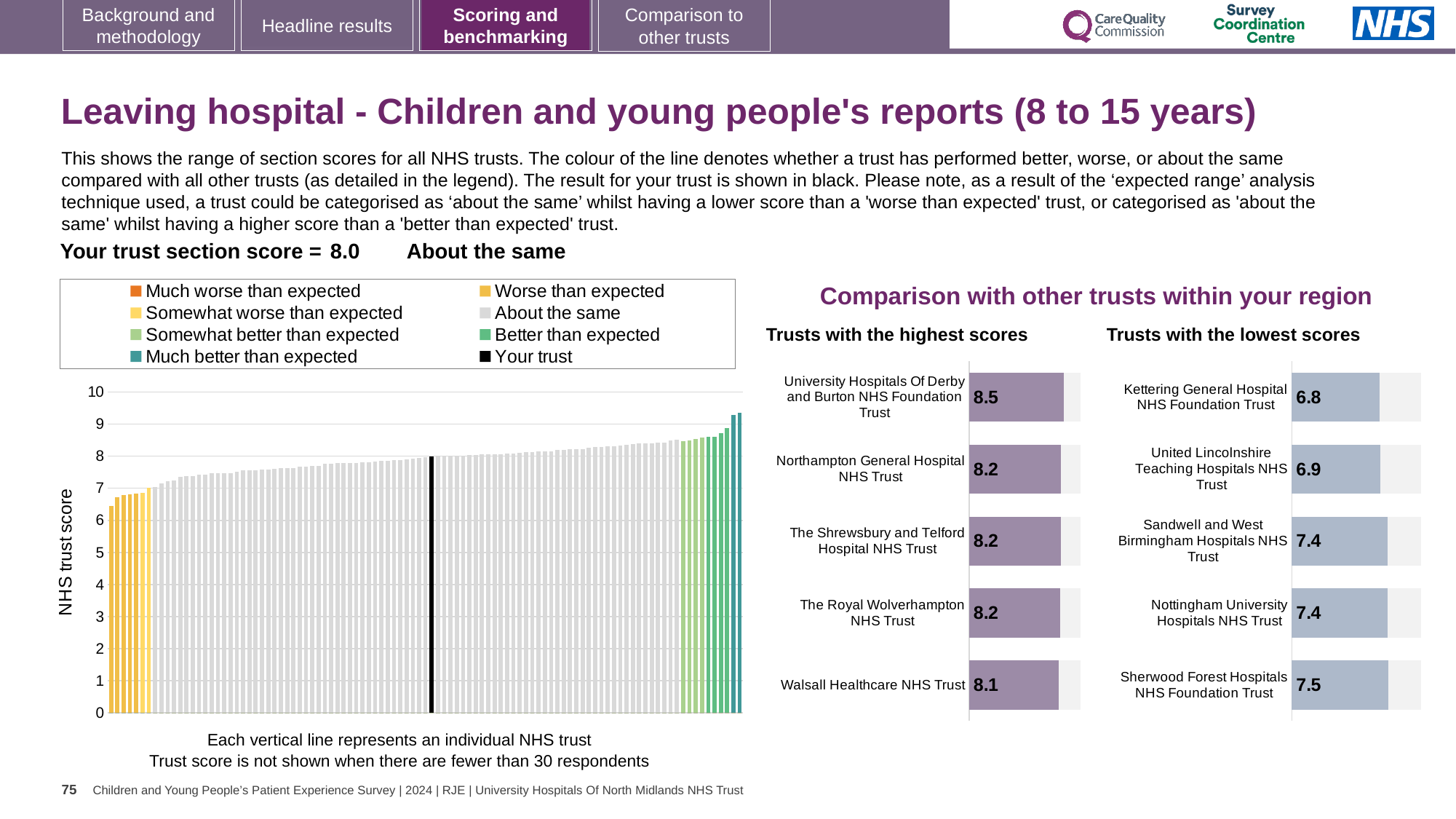
In the 'Trusts with the highest scores' chart, which trust has the highest score? University Hospitals Of Derby and Burton NHS Foundation Trust In the 'Trusts with the lowest scores' chart, which has the larger score: United Lincolnshire Teaching Hospitals NHS Trust or Nottingham University Hospitals NHS Trust? Nottingham University Hospitals NHS Trust In the 'Trusts with the highest scores' chart, what is the score for University Hospitals Of Derby and Burton NHS Foundation Trust? 8.5 In the 'Trusts with the lowest scores' chart, what is the score for Sherwood Forest Hospitals NHS Foundation Trust? 7.5 In the 'Trusts with the lowest scores' chart, which trust has the lowest score? Kettering General Hospital NHS Foundation Trust How many entries does the legend of the NHS trust score chart list? 8 In the NHS trust score chart on the left, do the bar values rise or fall from left to right? Rise In the 'Trusts with the lowest scores' chart, what is the score for Kettering General Hospital NHS Foundation Trust? 6.8 How many trusts are shown in the 'Trusts with the lowest scores' chart? 5 In the 'Trusts with the highest scores' chart, what is the score for Walsall Healthcare NHS Trust? 8.1 What type of chart is the NHS trust score chart on the left of the slide? Bar chart In the 'Trusts with the highest scores' chart, what is the difference between the scores of University Hospitals Of Derby and Burton NHS Foundation Trust and Walsall Healthcare NHS Trust? 0.4